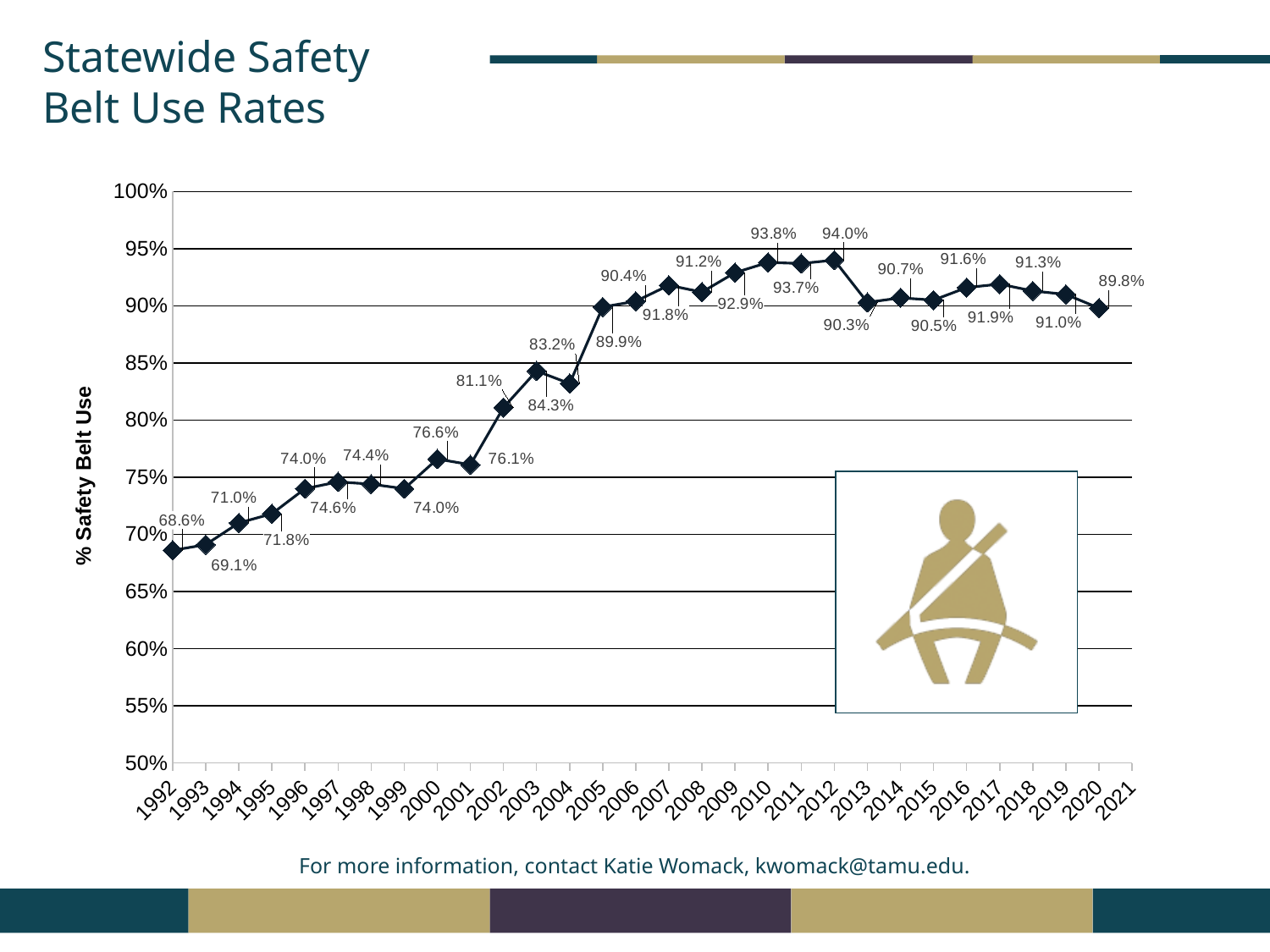
Is the safety belt use rate for 2002 greater or less than 80%? greater What is the label on the vertical axis of the chart? % Safety Belt Use What was the safety belt use rate in 1996? 74.0% What was the highest safety belt use rate shown on the chart? 94.0% By how many percentage points did the safety belt use rate drop from 2012 to 2013? 3.7 percentage points What was the safety belt use rate in 2005? 89.9% In which year was the statewide safety belt use rate highest? 2012 What kind of chart is shown on the slide? Line chart Which year had a higher safety belt use rate, 2003 or 2004? 2003 What was the safety belt use rate in 2016? 91.6% Overall, does the safety belt use rate rise or fall from 1992 to 2020? Rise In which year was the safety belt use rate lowest? 1992